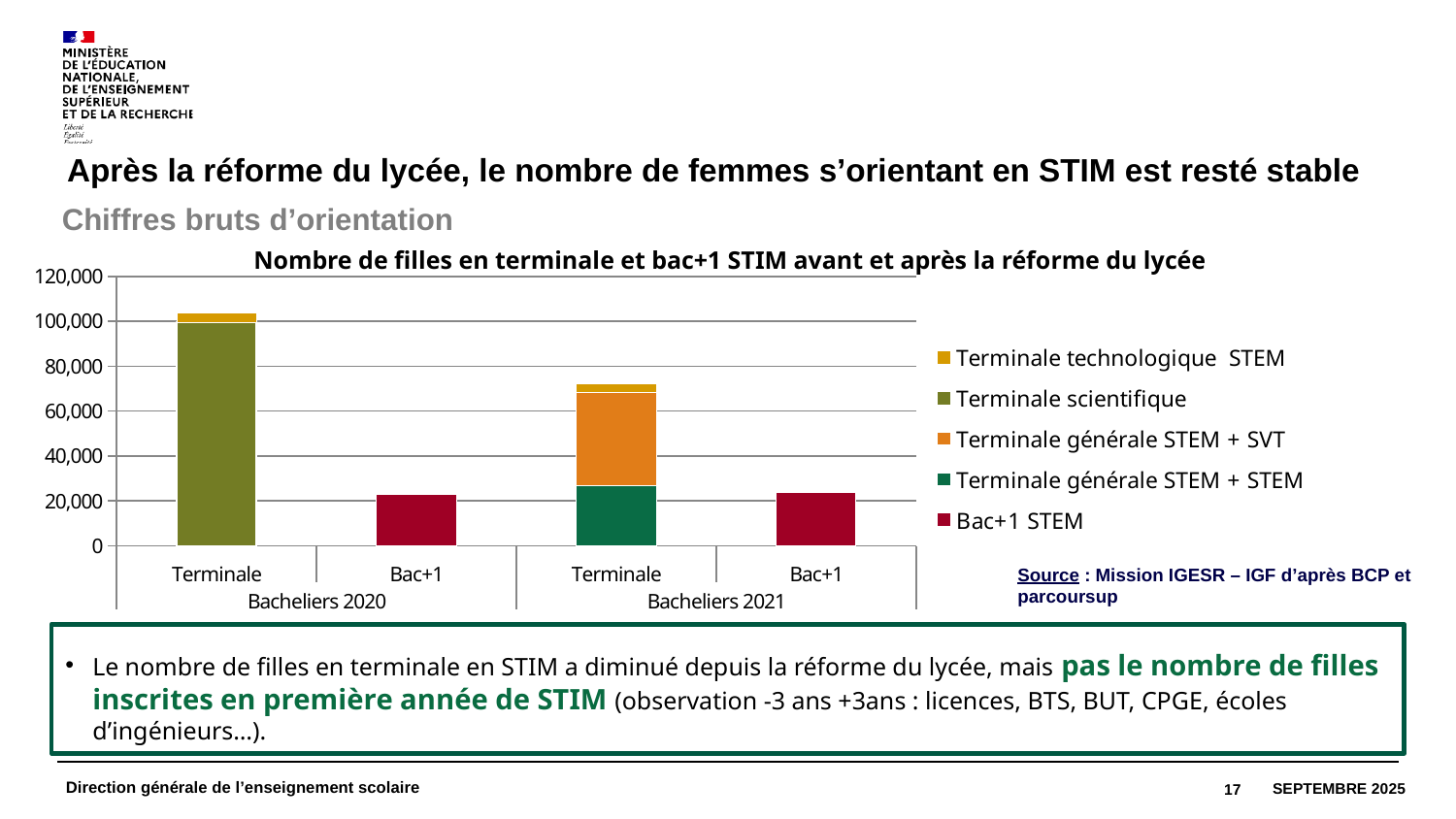
How many series does the chart legend list? 5 Which is larger for Bacheliers 2021: the Terminale bar or the Bac+1 bar? Terminale Which is larger: the Terminale bar for Bacheliers 2020 or the Terminale bar for Bacheliers 2021? Terminale, Bacheliers 2020 Is the total for the Terminale bar of Bacheliers 2021 greater or less than 80,000? less What is the title of the chart? Nombre de filles en terminale et bac+1 STIM avant et après la réforme du lycée Is the value for Bac+1 of Bacheliers 2021 greater or less than 40,000? less Is the total for the Terminale bar of Bacheliers 2020 greater or less than 80,000? greater Which bar is the tallest in the chart? Terminale, Bacheliers 2020 What kind of chart is shown on the slide? Stacked bar chart How many bars are plotted in the chart? 4 Which legend series is shown in dark red? Bac+1 STEM